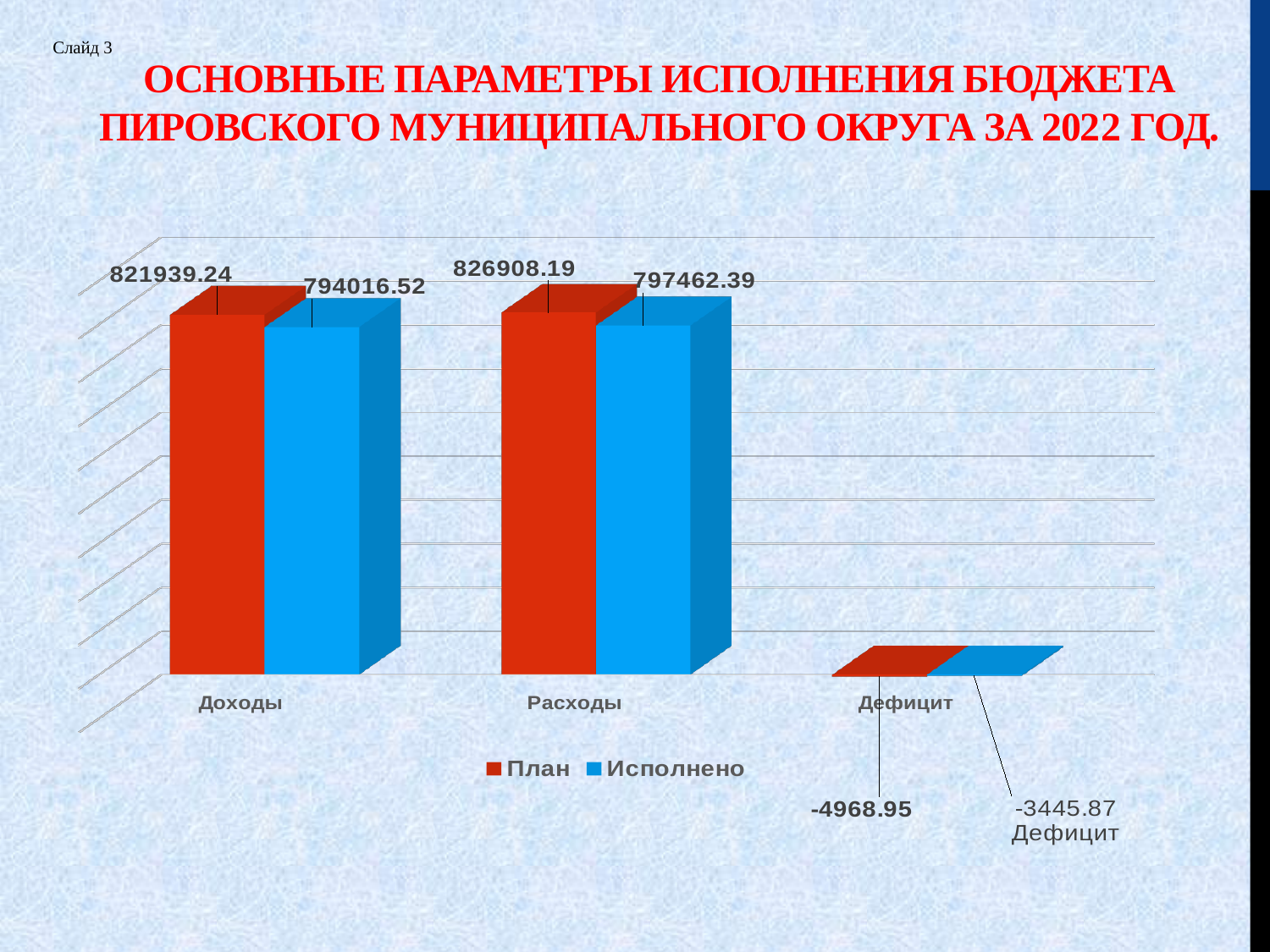
What is the Исполнено value for Расходы? 797462.39 What is the План value for Расходы? 826908.19 What is the План value for Дефицит? -4968.95 Which category has the lowest Исполнено value? Дефицит What is the План value for Доходы? 821939.24 What is the Исполнено value for Дефицит? -3445.87 What type of chart is shown on the slide? Bar chart Which category has the highest План value? Расходы How many series does the legend list? 2 Which is larger: the Исполнено value for Доходы or the Исполнено value for Расходы? Расходы What is the difference between the План and Исполнено values for Доходы? 27922.72 What is the Исполнено value for Доходы? 794016.52